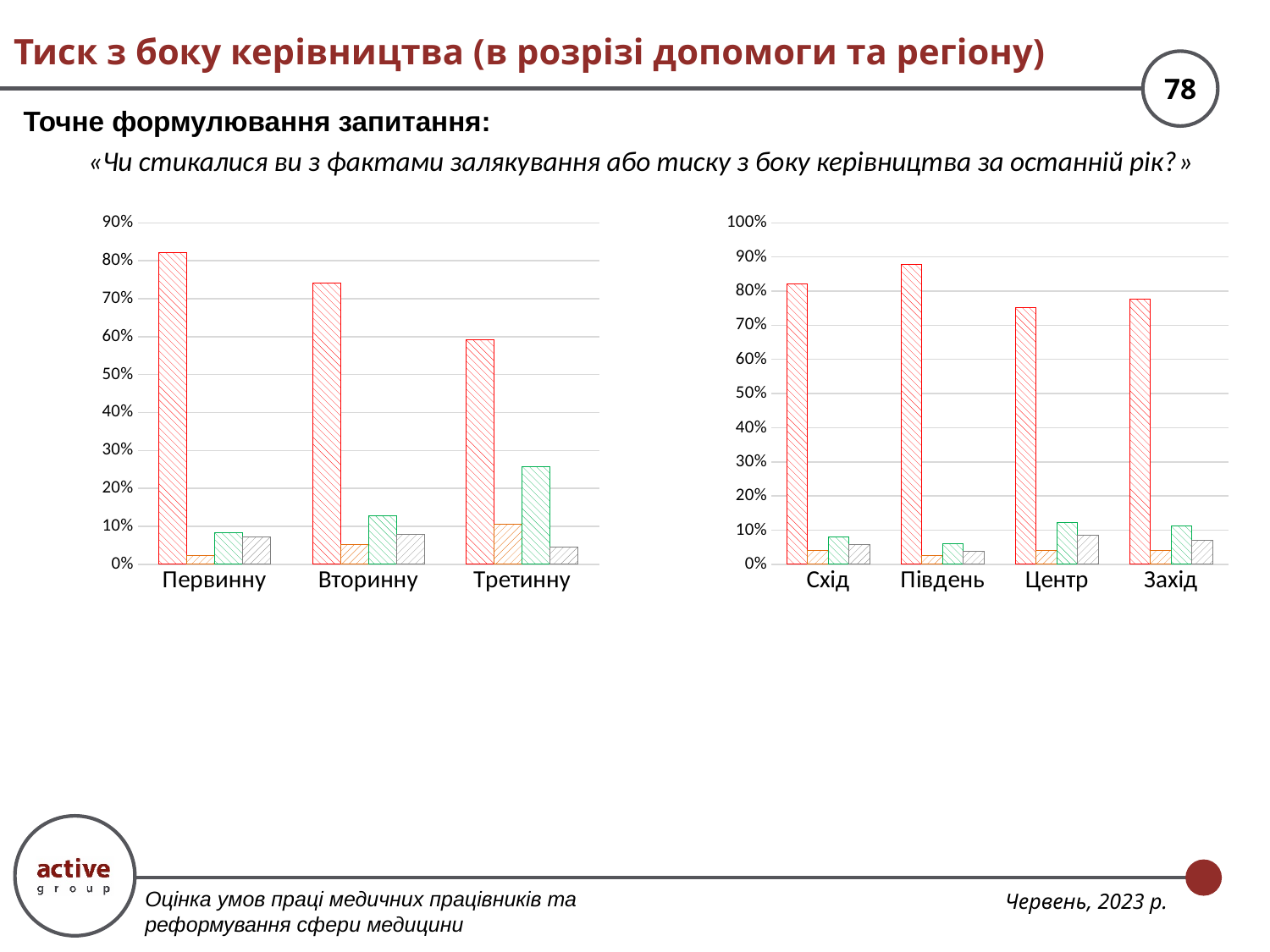
In the right chart, which region has the tallest red-outlined bar? Південь In the left chart, which category has the shortest red-outlined bar? Третинну In the right chart, is the red-outlined bar for Південь greater or less than 80%? greater In the left chart, which red-outlined bar is taller: Вторинну or Третинну? Вторинну How many categories are shown on the x axis of the left chart? 3 What kind of chart is the left chart (Первинну, Вторинну, Третинну)? bar chart In the right chart, is the red-outlined bar for Центр greater or less than 80%? less In the left chart, is the red-outlined bar for Первинну greater or less than 70%? greater In the left chart, which category has the tallest green-outlined bar? Третинну How many categories are shown on the x axis of the right chart (Схід, Південь, Центр, Захід)? 4 In the left chart, do the red-outlined bars rise or fall from Первинну to Третинну? fall In the left chart, which category has the tallest red-outlined bar? Первинну